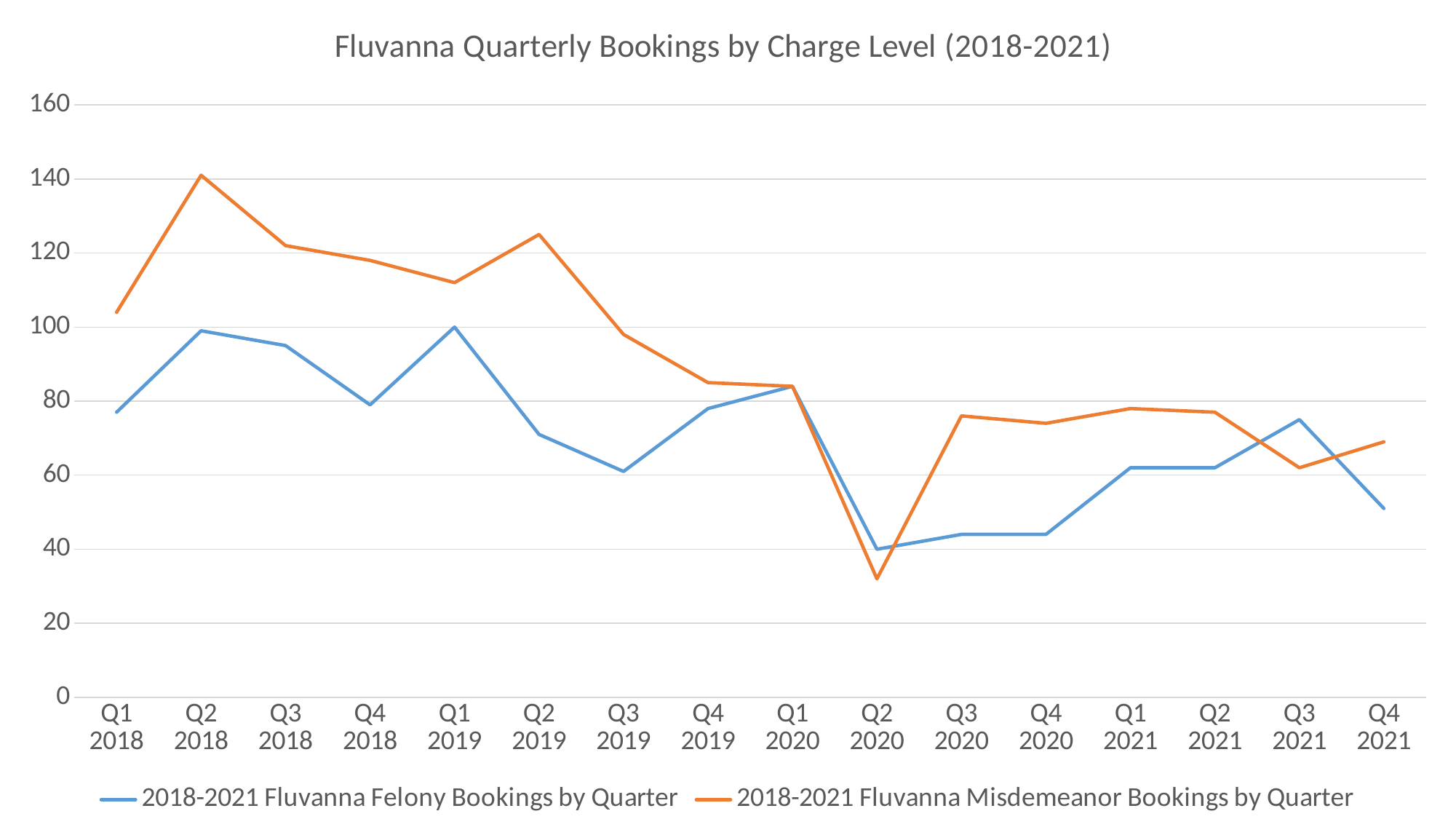
Is the value for misdemeanor bookings in Q1 2018 greater or less than 100? greater What kind of chart is shown on the slide? line chart What colour is the line for felony bookings? blue Do misdemeanor bookings rise or fall from Q2 2019 to Q2 2020? fall In which quarter do misdemeanor bookings reach their lowest value? Q2 2020 In Q3 2021, which series has the higher value, felony bookings or misdemeanor bookings? felony bookings How many quarters are plotted along the x axis? 16 Is the value for misdemeanor bookings in Q2 2020 greater or less than 40? less Is the value for felony bookings in Q4 2021 greater or less than 60? less How many series does the legend list? 2 In which quarter do misdemeanor bookings reach their highest value? Q2 2018